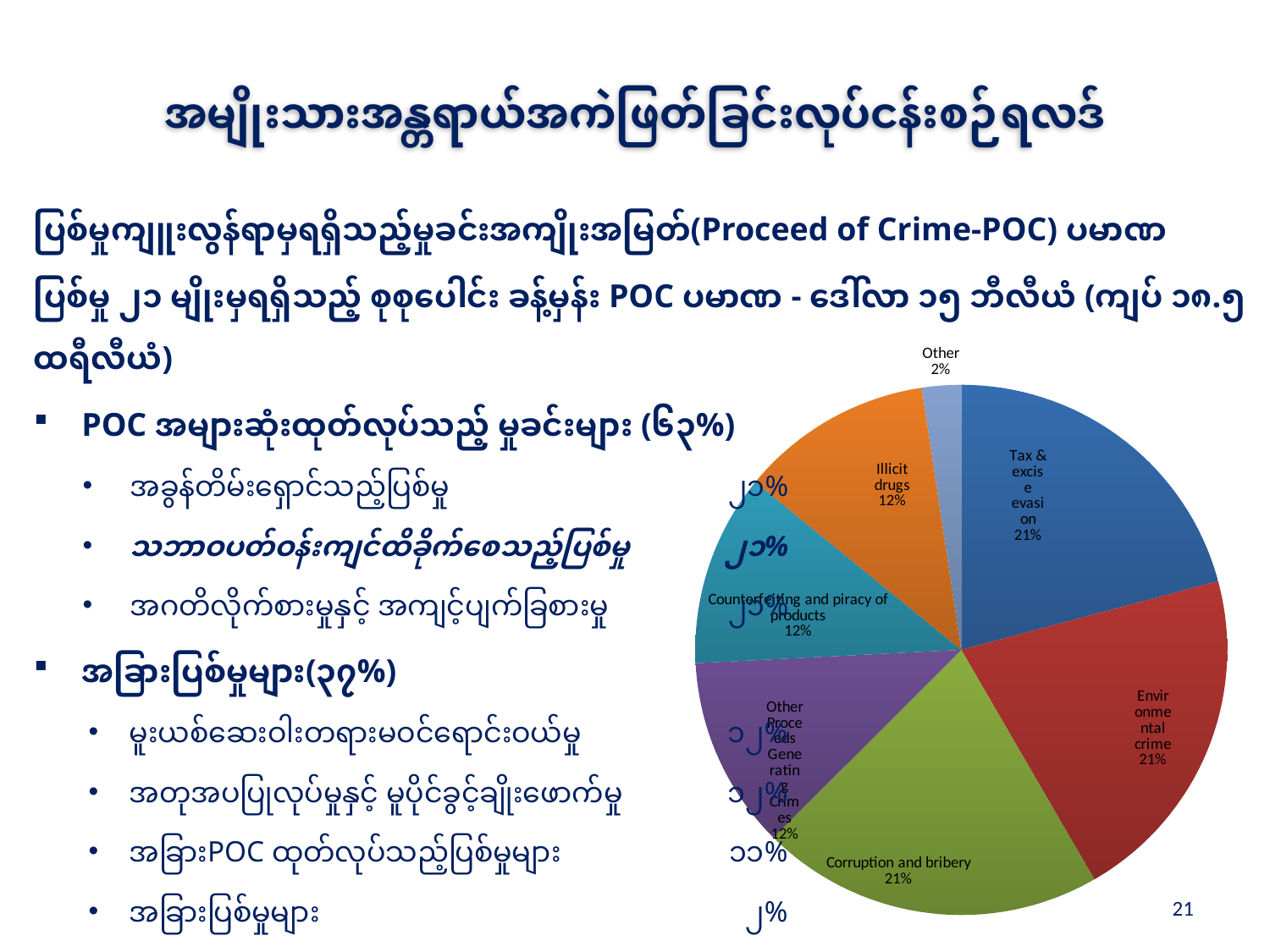
What percentage is shown for Corruption and bribery? 21% Which slice of the pie is the smallest? Other How many slices does the pie chart have? 7 What share of the pie does Tax & excise evasion account for? 21% What is the difference in percentage points between Illicit drugs and Other? 10 What is the difference in percentage points between Corruption and bribery and Illicit drugs? 9 What kind of chart is shown on the slide? pie chart What is the share of the Other slice? 2% What percentage is shown for Environmental crime? 21% Which is larger, the share for Environmental crime or the share for Counterfeiting and piracy of products? Environmental crime What percentage is shown for Illicit drugs? 12% What percentage is shown for Counterfeiting and piracy of products? 12%